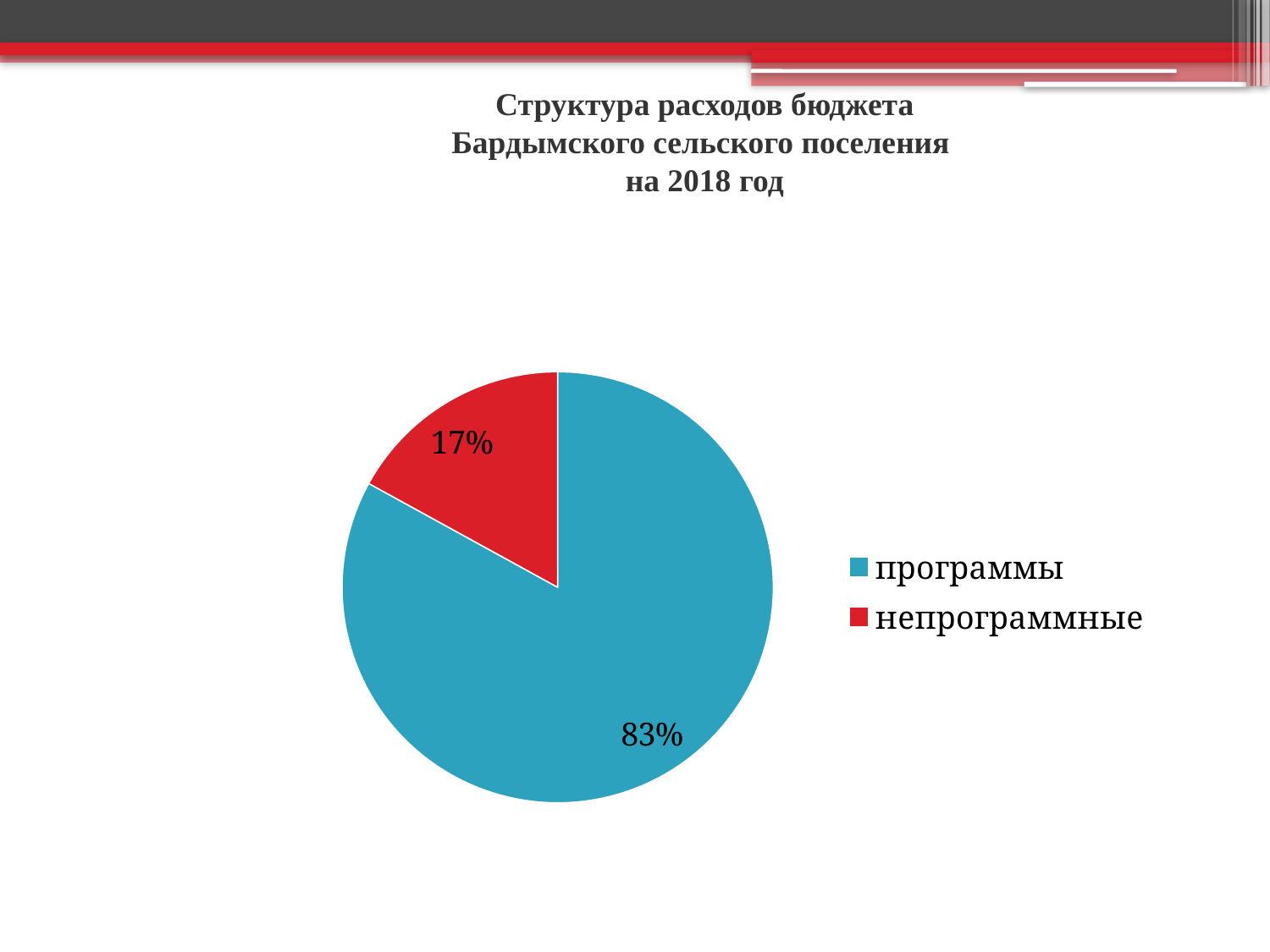
Which category has the largest slice of the pie? программы What share of the pie does the 'программы' slice represent? 83% Which is larger: the 'программы' slice or the 'непрограммные' slice? программы Which category has the smallest slice of the pie? непрограммные What share of the pie does the 'непрограммные' slice represent? 17% What kind of chart is shown on the slide? pie chart What is the title of the chart on the slide? Структура расходов бюджета Бардымского сельского поселения на 2018 год What is the difference in percentage points between the 'программы' and 'непрограммные' slices? 66 How many entries does the legend list? 2 What colour is the 'непрограммные' slice? red How many categories does the pie chart show? 2